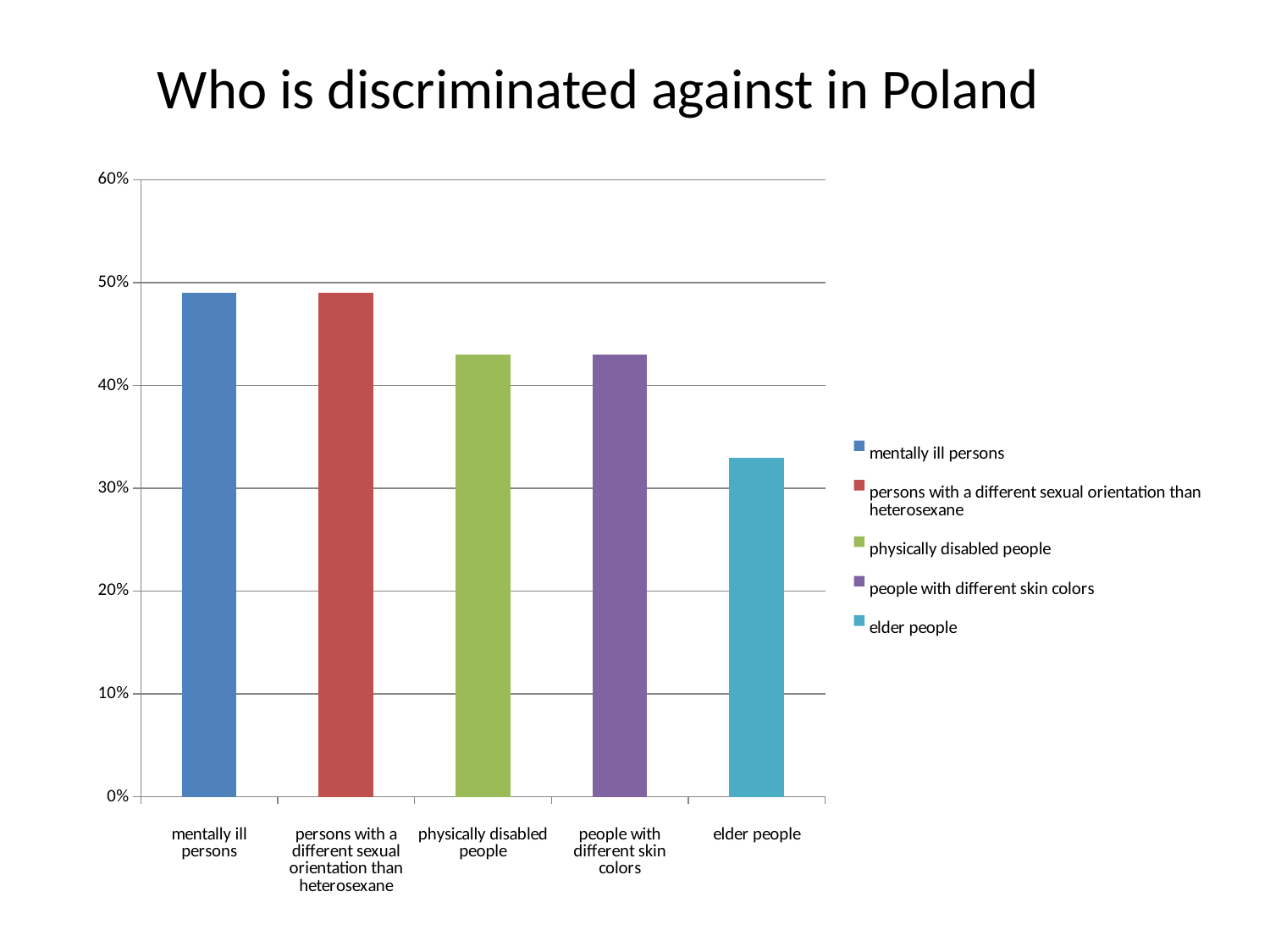
Which category has the lowest value in the chart? elder people What is the title of the chart? Who is discriminated against in Poland Do the bar values generally rise or fall from left to right along the x axis? fall How many entries does the chart's legend list? 5 Which is larger, the value for physically disabled people or the value for elder people? physically disabled people Is the value for mentally ill persons greater or less than 40%? greater Is the value for physically disabled people greater or less than 50%? less Which is larger, the value for mentally ill persons or the value for elder people? mentally ill persons Is the value for people with different skin colors greater or less than 40%? greater How many categories are shown on the x axis of the chart? 5 What kind of chart is shown on the slide? bar chart